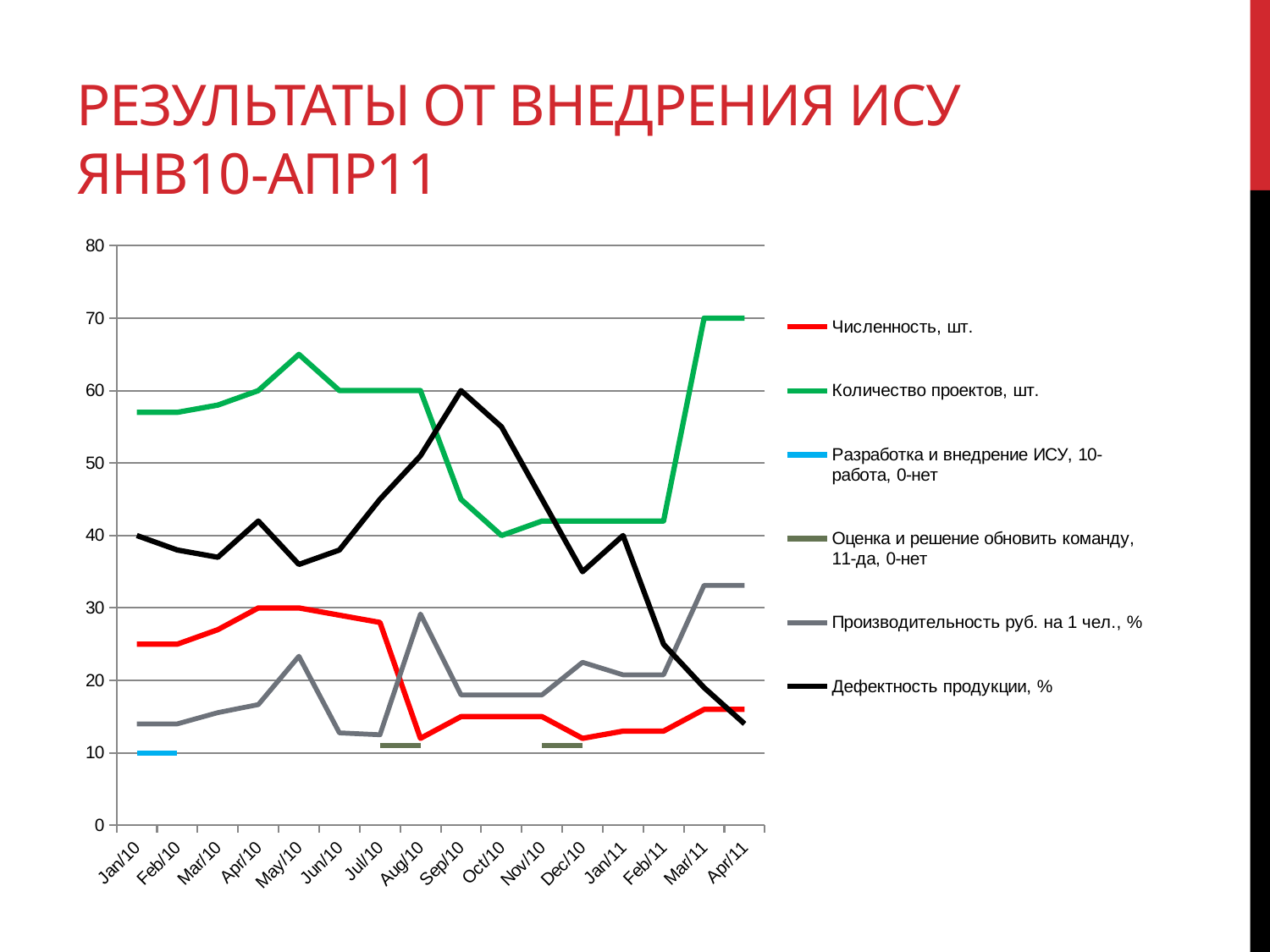
In which month is Дефектность продукции, % at its lowest? Apr/11 What is the value of Разработка и внедрение ИСУ in Jan/10? 10 Does Дефектность продукции, % rise or fall from Sep/10 to Apr/11? fall What is the value of Дефектность продукции, % in Sep/10? 60 Which series reaches the highest value on the chart? Количество проектов, шт. How many series does the legend list? 6 What kind of chart is shown on the slide? line chart How many months are shown along the x axis? 16 Is the value for Производительность руб. на 1 чел., % in Mar/11 greater or less than 30? greater Is the value for Численность, шт. in Jan/10 greater or less than 30? less What is the value of Количество проектов, шт. in Apr/11? 70 Is the value for Дефектность продукции, % in Dec/10 greater or less than 40? less